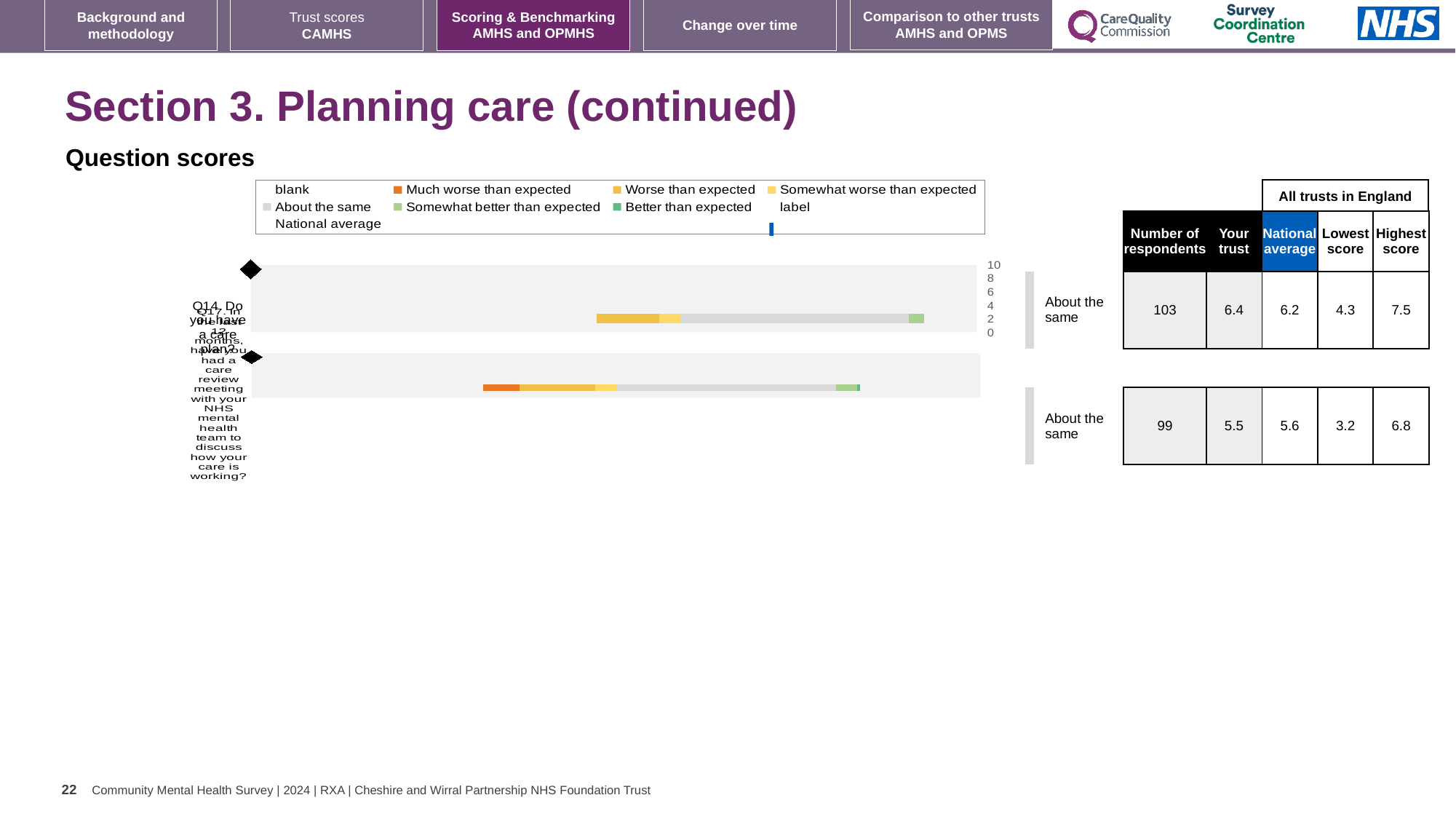
For Q17, which is larger: the trust's score or the national average? National average What kind of chart is shown under 'Question scores'? bar chart What benchmark category is shown for Q17? About the same For Q14, which is larger: the trust's score or the national average? Your trust How many questions (bars) are plotted in the chart? 2 Which question has the higher 'Your trust' score, Q14 or Q17? Q14 What is the national average score for Q17 (care review meeting in the last 12 months)? 5.6 How many respondents answered Q14? 103 What is the 'Your trust' score for Q14 (Do you have a care plan?)? 6.4 What is the highest score across all trusts in England for Q17? 6.8 What is the difference between the trust's score and the national average for Q14? 0.2 What is the difference between the highest and lowest scores across all trusts in England for Q14? 3.2